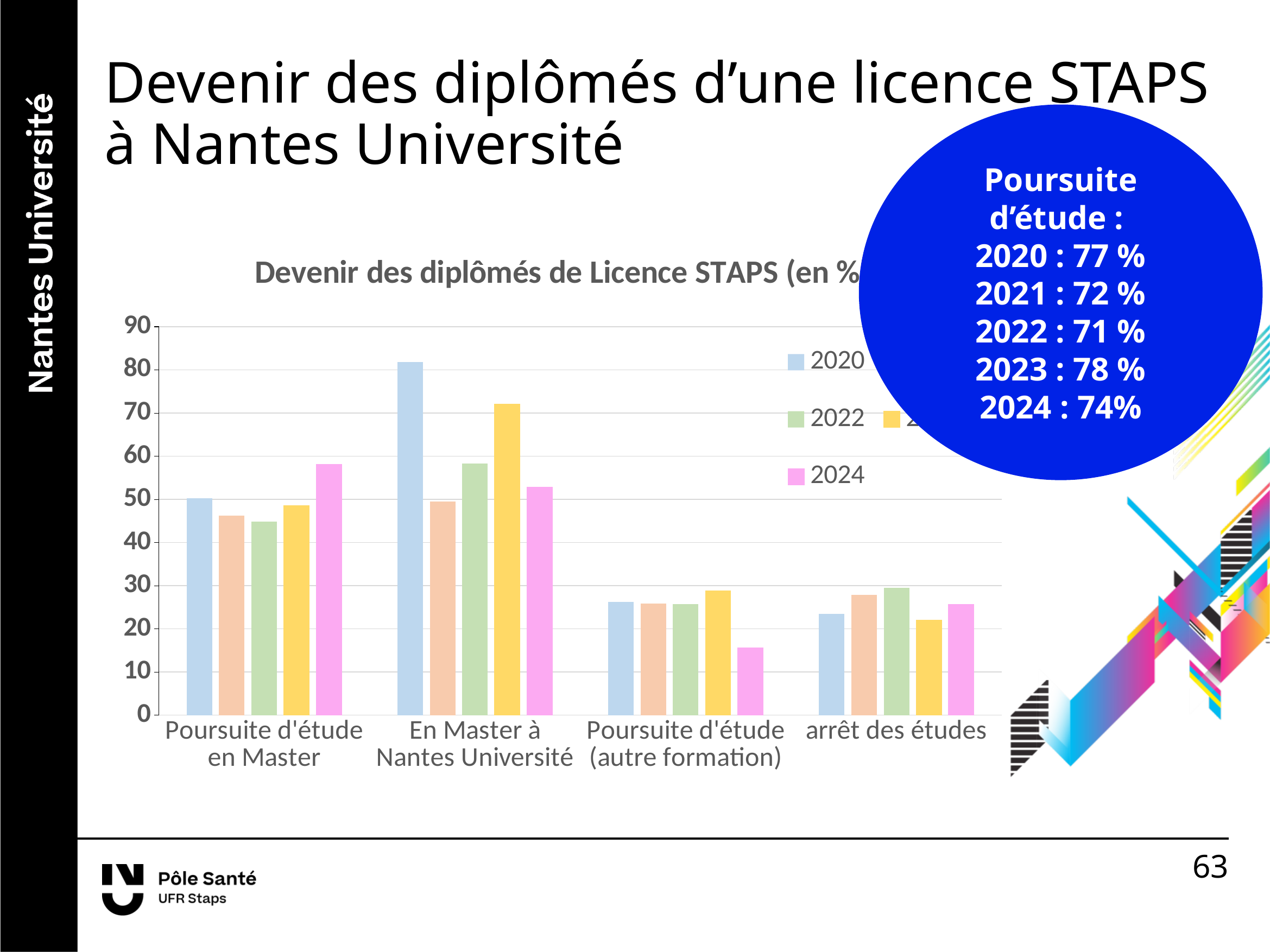
For 'arrêt des études', which is larger: the 2020 bar or the 2022 bar? 2022 How many categories are shown on the x axis of the chart? 4 Which category has the lowest 2024 bar? Poursuite d'étude (autre formation) Is the 2024 value for 'Poursuite d'étude (autre formation)' greater or less than 20? less Is the 2020 value for 'En Master à Nantes Université' greater or less than 70? greater For 'Poursuite d'étude en Master', which is larger: the 2020 bar or the 2024 bar? 2024 Which category has the highest 2020 bar? En Master à Nantes Université What colour are the bars for the 2024 series? pink What is the title of the chart? Devenir des diplômés de Licence STAPS (en %) What kind of chart is shown on the slide? bar chart Is the 2020 value for 'Poursuite d'étude en Master' greater or less than 40? greater